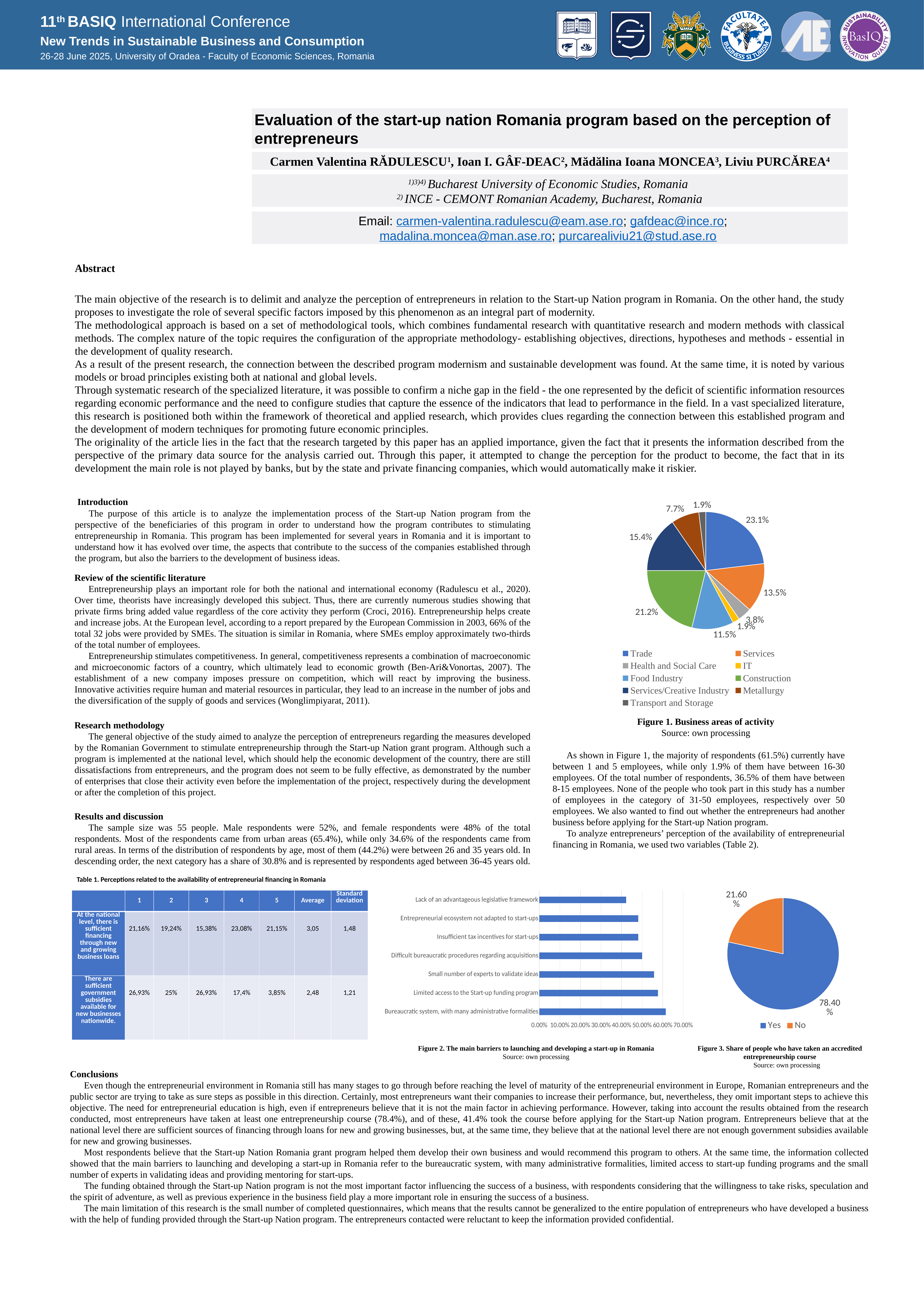
In Figure 3 (Share of people who have taken an accredited entrepreneurship course), what share answered Yes? 78.40% In Figure 2 (The main barriers to launching and developing a start-up in Romania), is the value for 'Lack of an advantageous legislative framework' greater or less than 50.00%? less In Figure 2 (The main barriers to launching and developing a start-up in Romania), what kind of chart is shown? bar chart In Figure 1 (Business areas of activity), what share of respondents is in Construction? 21.2% In Figure 1 (Business areas of activity), what share of respondents is in Trade? 23.1% In Figure 2 (The main barriers to launching and developing a start-up in Romania), how many barriers are plotted? 7 In Figure 1 (Business areas of activity), what kind of chart is shown? pie chart In Figure 1 (Business areas of activity), which business area has the largest share? Trade In Figure 2 (The main barriers to launching and developing a start-up in Romania), which barrier has the lowest value? Lack of an advantageous legislative framework In Figure 2 (The main barriers to launching and developing a start-up in Romania), which barrier has the highest value? Bureaucratic system, with many administrative formalities In Figure 1 (Business areas of activity), how many business areas does the legend list? 9 In Figure 1 (Business areas of activity), what is the difference between the shares for Trade and Services? 9.6%